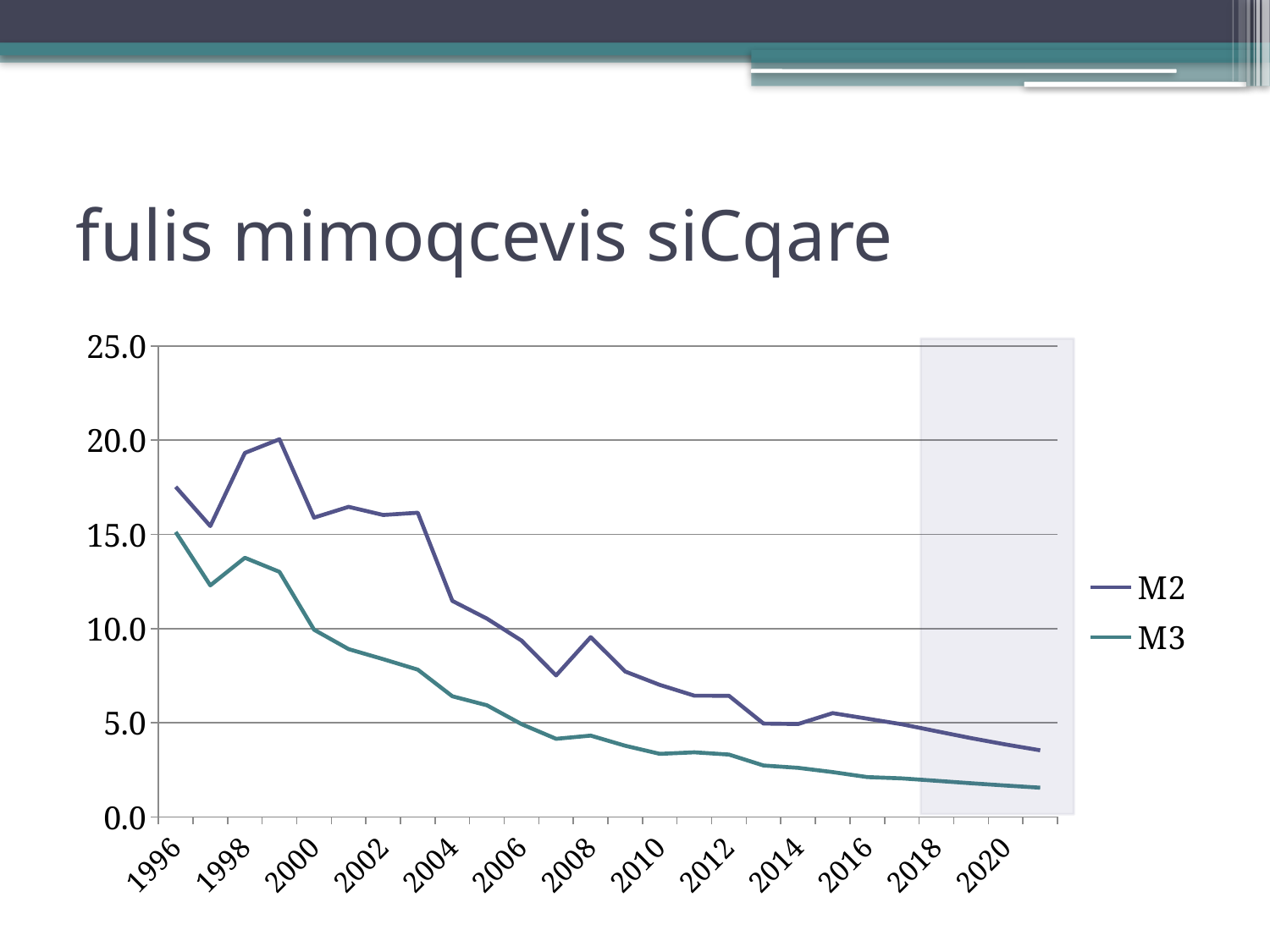
Which series has the larger value in 2000, M2 or M3? M2 Is the value for M2 in 2004 greater or less than 10.0? greater Is the value for M3 in 2010 greater or less than 5.0? less Is the value for M2 in 2020 greater or less than 5.0? less Do the values of the M3 series generally rise or fall from 1996 to 2020? fall What are the names of the series in the legend? M2 and M3 What kind of chart is shown on the slide? line chart What is the title of the slide containing the chart? fulis mimoqcevis siCqare Do the values of the M2 series generally rise or fall from 2000 to 2020? fall In which year does the M2 series reach its highest value? 1999 How many series does the legend list? 2